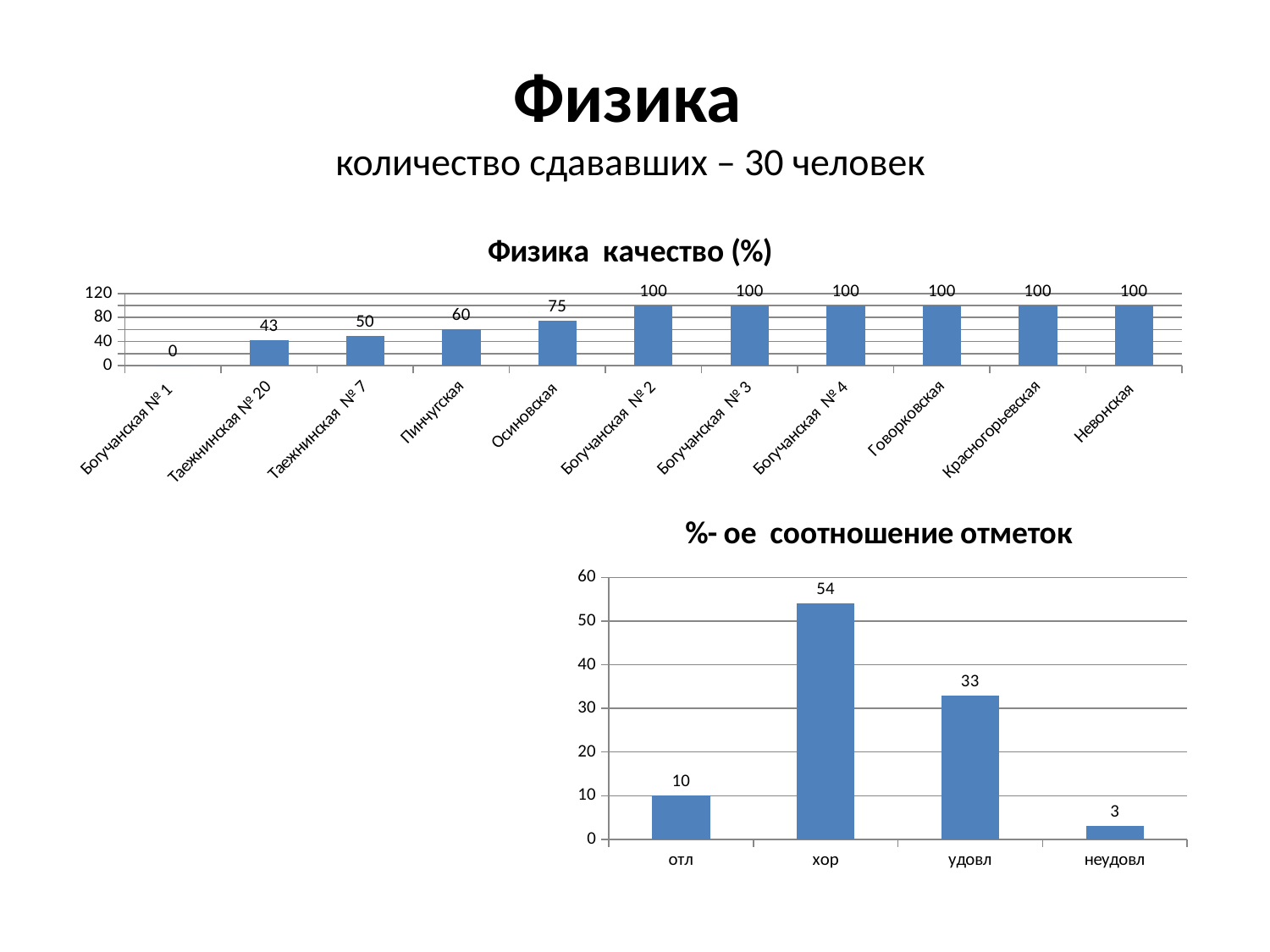
In the chart titled 'Физика качество (%)', what is the value for Осиновская? 75 In the chart titled 'Физика качество (%)', which category has the lowest value? Богучанская № 1 In the chart titled '%- ое соотношение отметок', which category has the lowest value? неудовл In the chart titled 'Физика качество (%)', how many categories are shown on the x axis? 11 In the chart titled 'Физика качество (%)', how many categories have a value of 100? 6 In the chart titled '%- ое соотношение отметок', what is the difference between the values for хор and удовл? 21 In the chart titled 'Физика качество (%)', what is the difference between the values for Пинчугская and Таежнинская № 7? 10 In the chart titled '%- ое соотношение отметок', which is larger: the value for отл or the value for удовл? удовл In the chart titled '%- ое соотношение отметок', which category has the highest value? хор What kind of chart is the chart titled '%- ое соотношение отметок'? bar chart In the chart titled 'Физика качество (%)', what is the value for Таежнинская № 20? 43 In the chart titled '%- ое соотношение отметок', what is the value for хор? 54